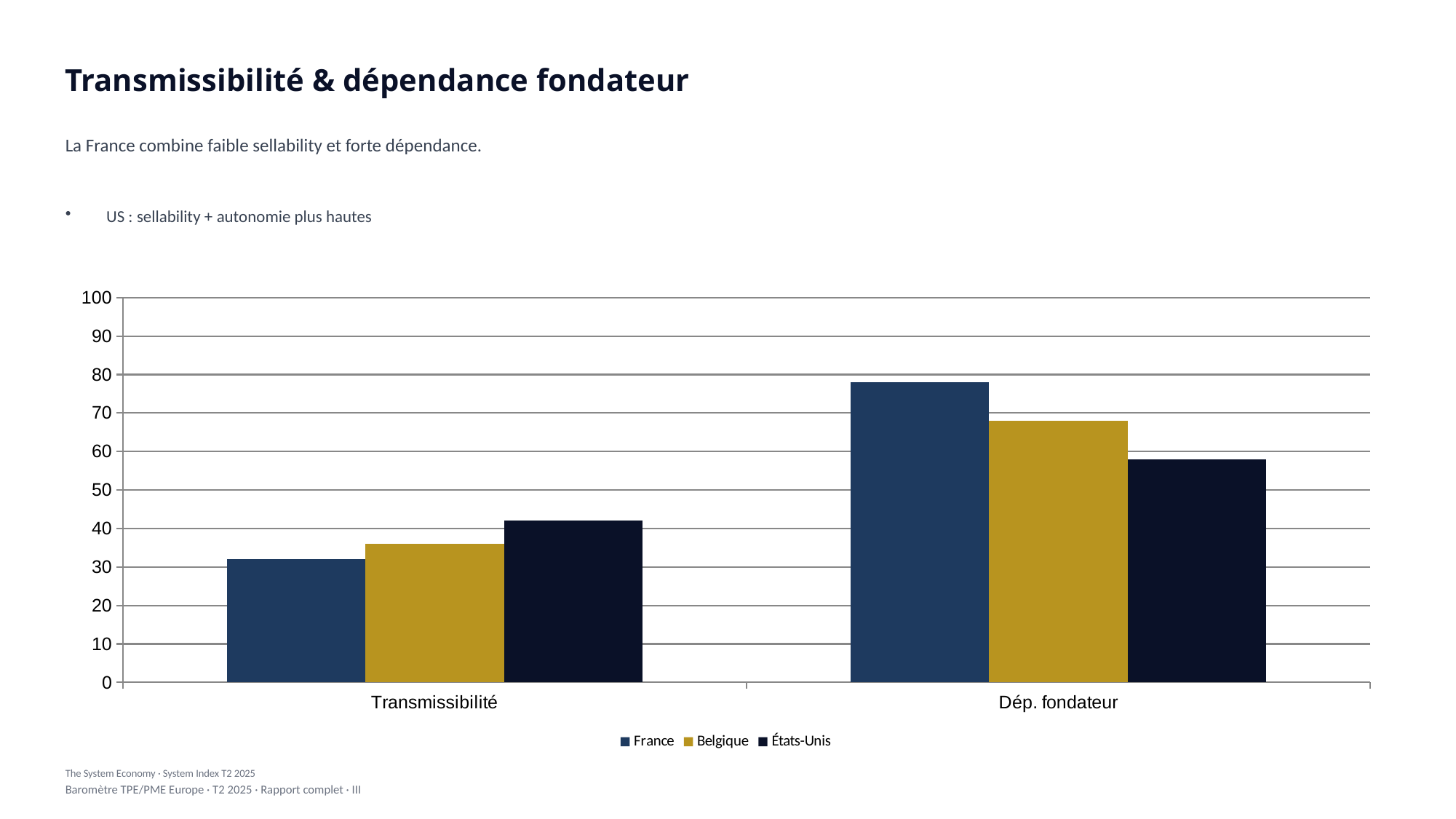
Is the value for États-Unis in Transmissibilité greater or less than 50? less Which series has the highest value for Transmissibilité? États-Unis Which series is shown in gold/yellow in the legend? Belgique How many series does the legend list? 3 Which series has the highest value for Dép. fondateur? France Which series has the lowest value for Transmissibilité? France Is the value for France in Dép. fondateur greater or less than 70? greater What kind of chart is shown on the slide? bar chart Which is larger: the value for France in Transmissibilité or the value for France in Dép. fondateur? Dép. fondateur How many categories are shown on the x axis? 2 Which series has the lowest value for Dép. fondateur? États-Unis Is the value for Belgique in Dép. fondateur greater or less than 60? greater